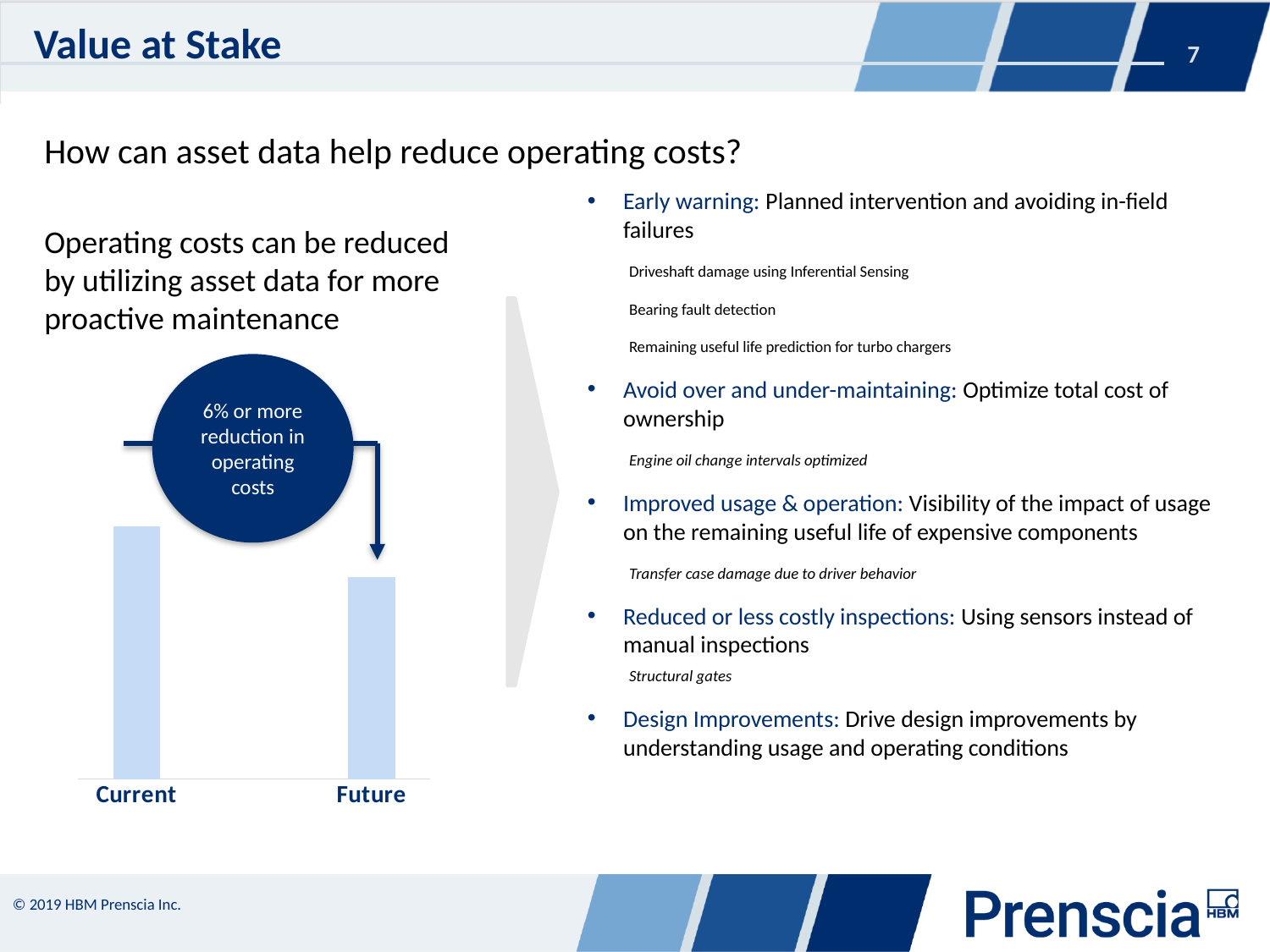
Which category has the shortest bar in the chart? Future How many categories does the bar chart show? 2 Which category has the tallest bar in the chart? Current What are the two category labels on the x axis of the chart? Current and Future Is the bar for Current taller or shorter than the bar for Future? taller What kind of chart is shown on the slide? bar chart What reduction in operating costs does the circle callout above the chart state? 6% or more reduction in operating costs Do the bars rise or fall from Current to Future? fall